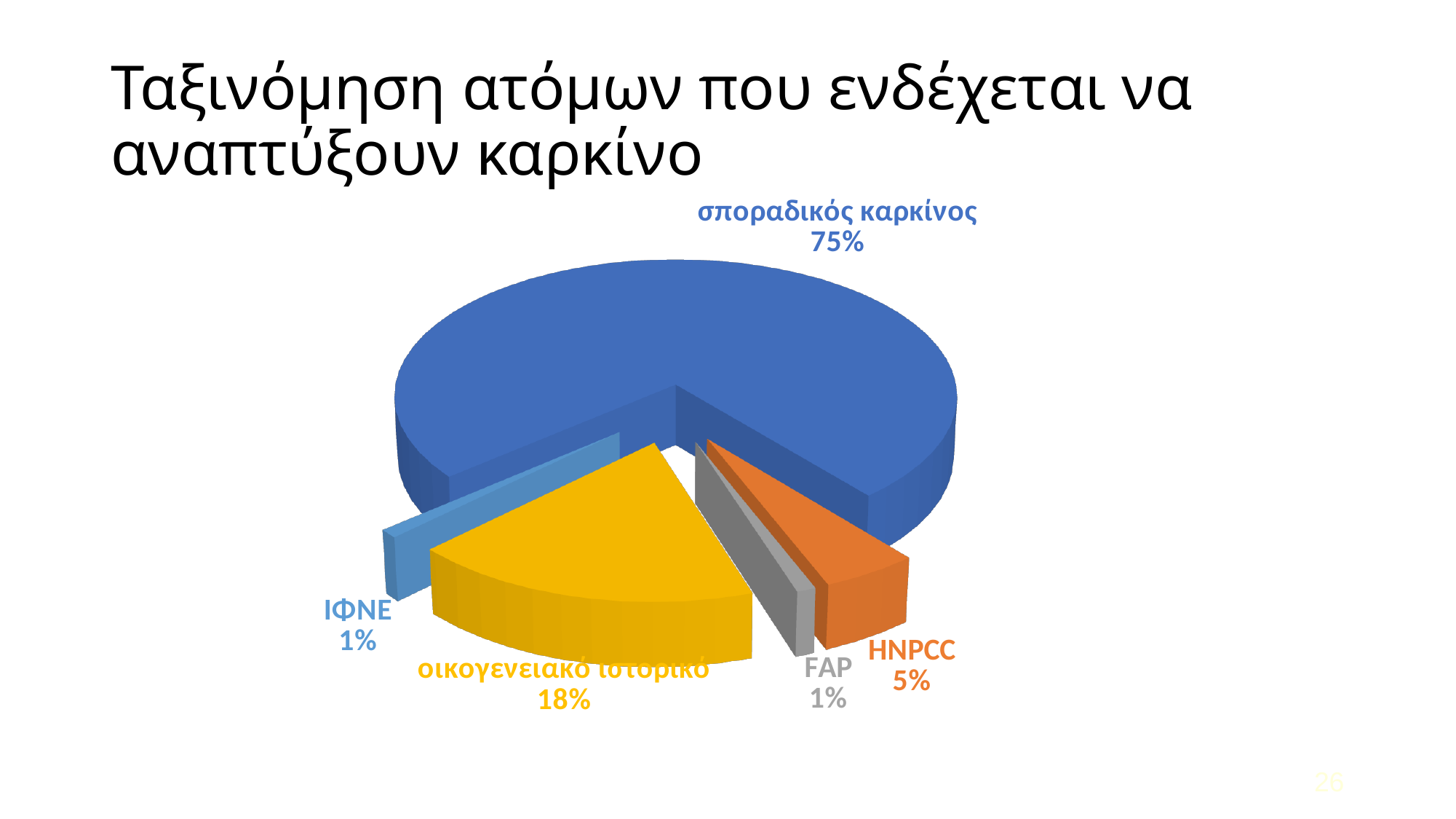
Which category has the largest share of the pie? σποραδικός καρκίνος What colour is the slice for οικογενειακό ιστορικό? yellow What is the value shown for FAP? 1% What is the value shown for οικογενειακό ιστορικό? 18% What is the value shown for ΙΦΝΕ? 1% How many slices does the pie chart have? 5 What share of the pie does σποραδικός καρκίνος represent? 75% What is the difference between the shares of οικογενειακό ιστορικό and HNPCC? 13% What is the difference between the shares of σποραδικός καρκίνος and οικογενειακό ιστορικό? 57% What is the value shown for HNPCC? 5% What kind of chart is shown on the slide? pie chart Which is larger, the share for HNPCC or the share for FAP? HNPCC